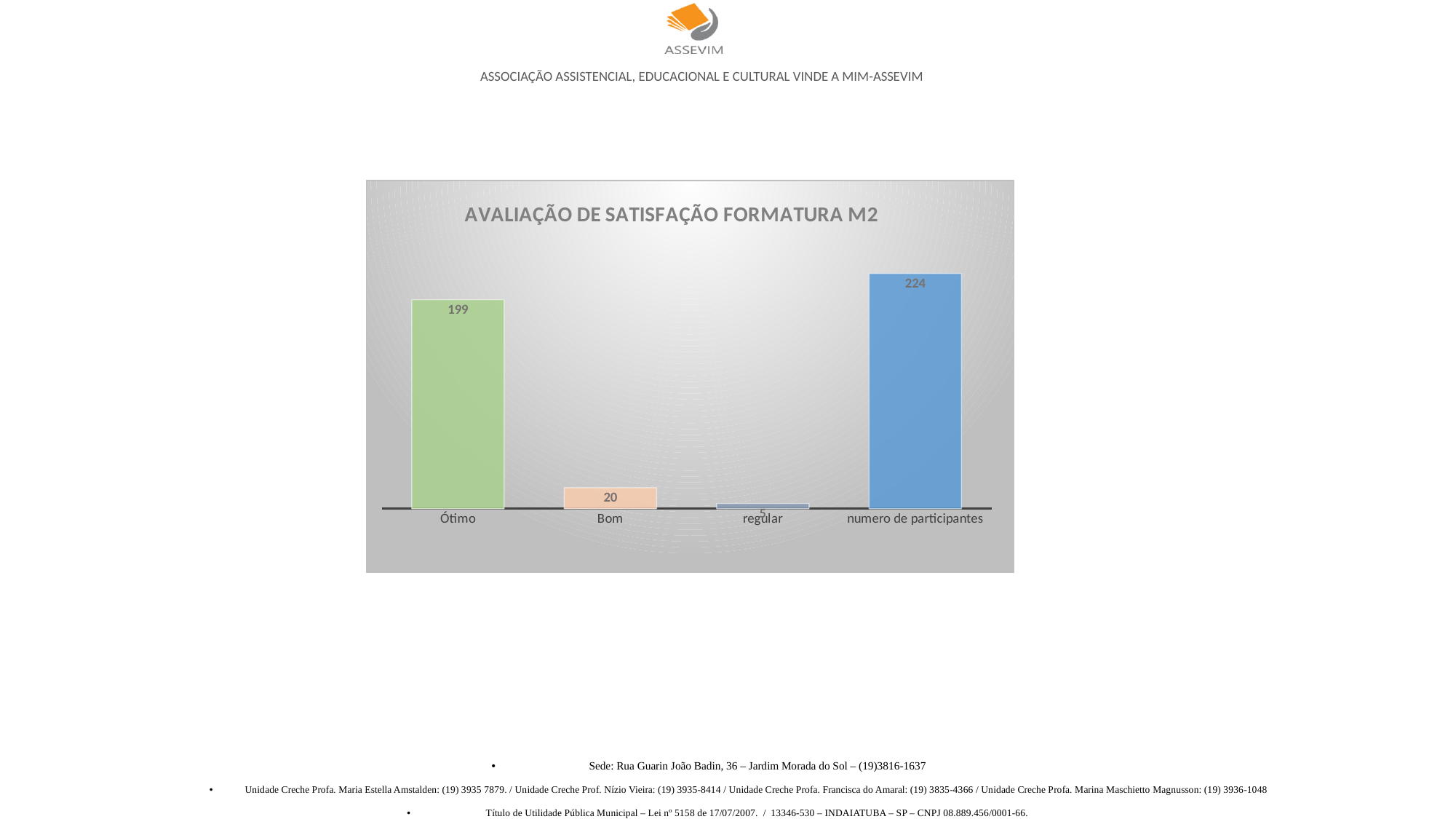
What is the value for Bom? 20 What kind of chart is shown on the slide? bar chart What is the value for numero de participantes? 224 Which category has the highest value? numero de participantes What is the difference between the values for numero de participantes and Ótimo? 25 What is the difference between the values for Ótimo and Bom? 179 How many categories are shown in the chart? 4 What is the value for Ótimo? 199 What is the title of the chart? AVALIAÇÃO DE SATISFAÇÃO FORMATURA M2 What is the value for regular? 5 Which category has the lowest value? regular Which is larger, the value for Bom or the value for regular? Bom